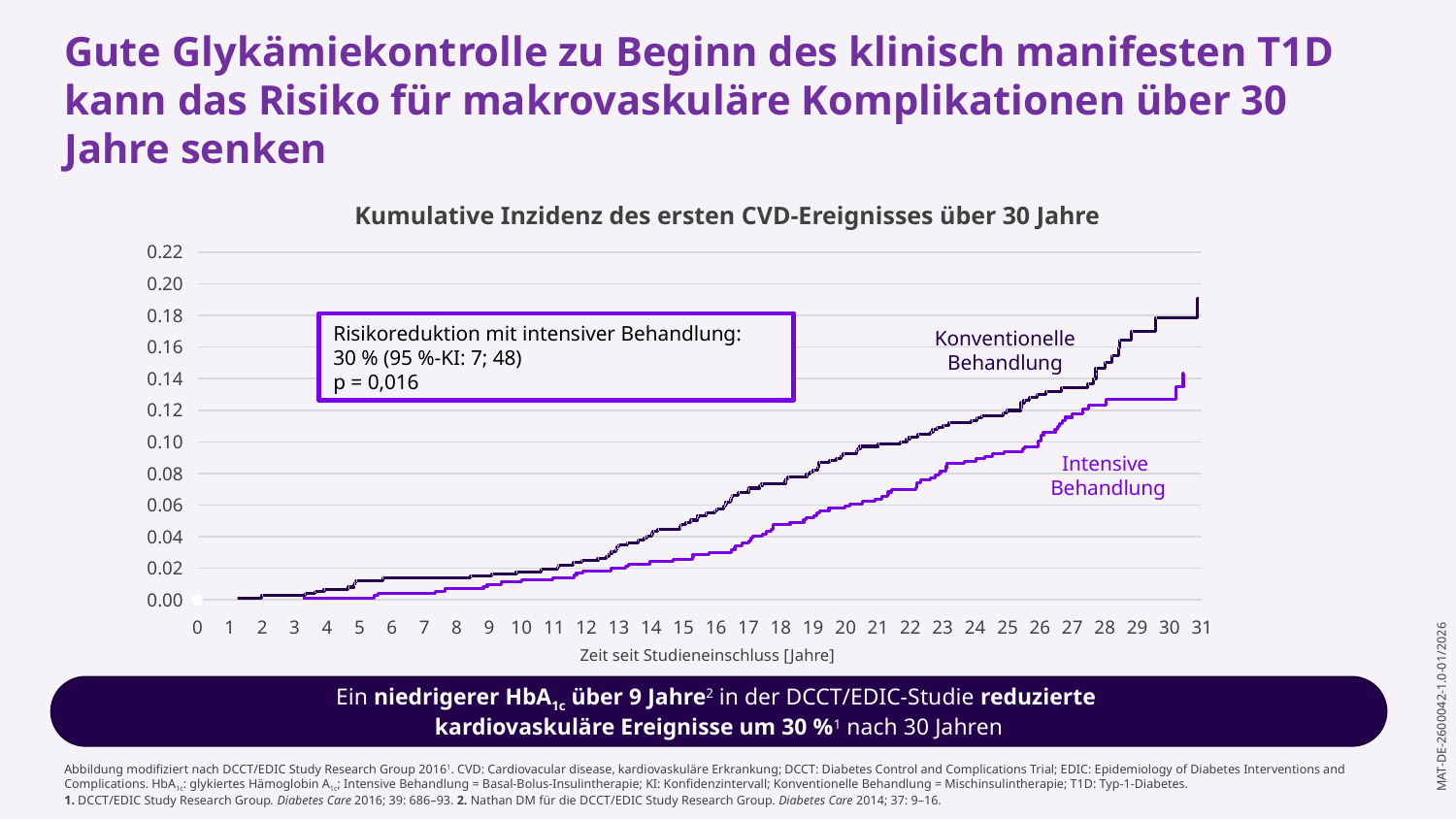
What is the title of the chart? Kumulative Inzidenz des ersten CVD-Ereignisses über 30 Jahre What kind of chart is shown on the slide? line chart Is the value for Konventionelle Behandlung at year 10 greater or less than 0.04? less What is the last year shown on the x axis? 31 How many series (treatment groups) are plotted in the chart? 2 What is the highest value shown on the y axis? 0.22 Do the cumulative incidence curves rise or fall as time since study enrolment increases? rise Is the value for Konventionelle Behandlung at year 30 greater or less than 0.16? greater Is the value for Intensive Behandlung at year 20 greater or less than 0.08? less At year 30, which curve is higher: Konventionelle Behandlung or Intensive Behandlung? Konventionelle Behandlung What is the label of the x axis? Zeit seit Studieneinschluss [Jahre]